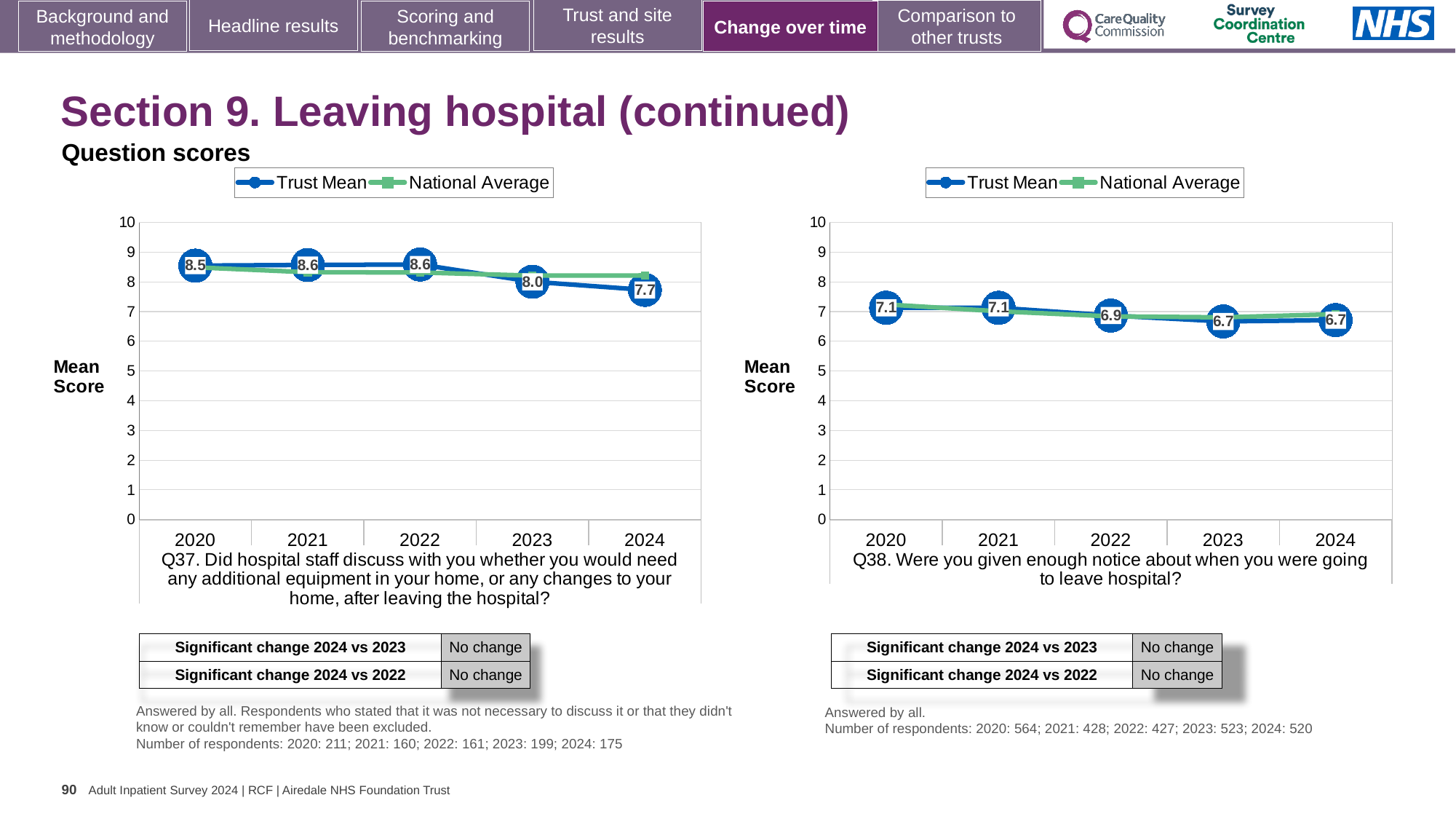
In the Q37 chart on the left, what is the Trust Mean score for 2024? 7.7 In the Q37 chart on the left, what is the difference between the Trust Mean scores for 2022 and 2024? 0.9 How many years are shown on the x axis of the Q38 chart on the right? 5 In the Q37 chart on the left, what is the Trust Mean score for 2020? 8.5 In the Q38 chart on the right, what is the Trust Mean score for 2024? 6.7 In the Q38 chart on the right, what is the Trust Mean score for 2022? 6.9 How many series does the legend of the Q37 chart on the left list? 2 In the Q37 chart on the left, which year has the lowest Trust Mean score? 2024 In the Q38 chart on the right, what is the difference between the Trust Mean scores for 2020 and 2024? 0.4 What kind of chart is the Q38 chart on the right? Line chart In the Q38 chart on the right, which year has the highest Trust Mean score, 2020 or 2022? 2020